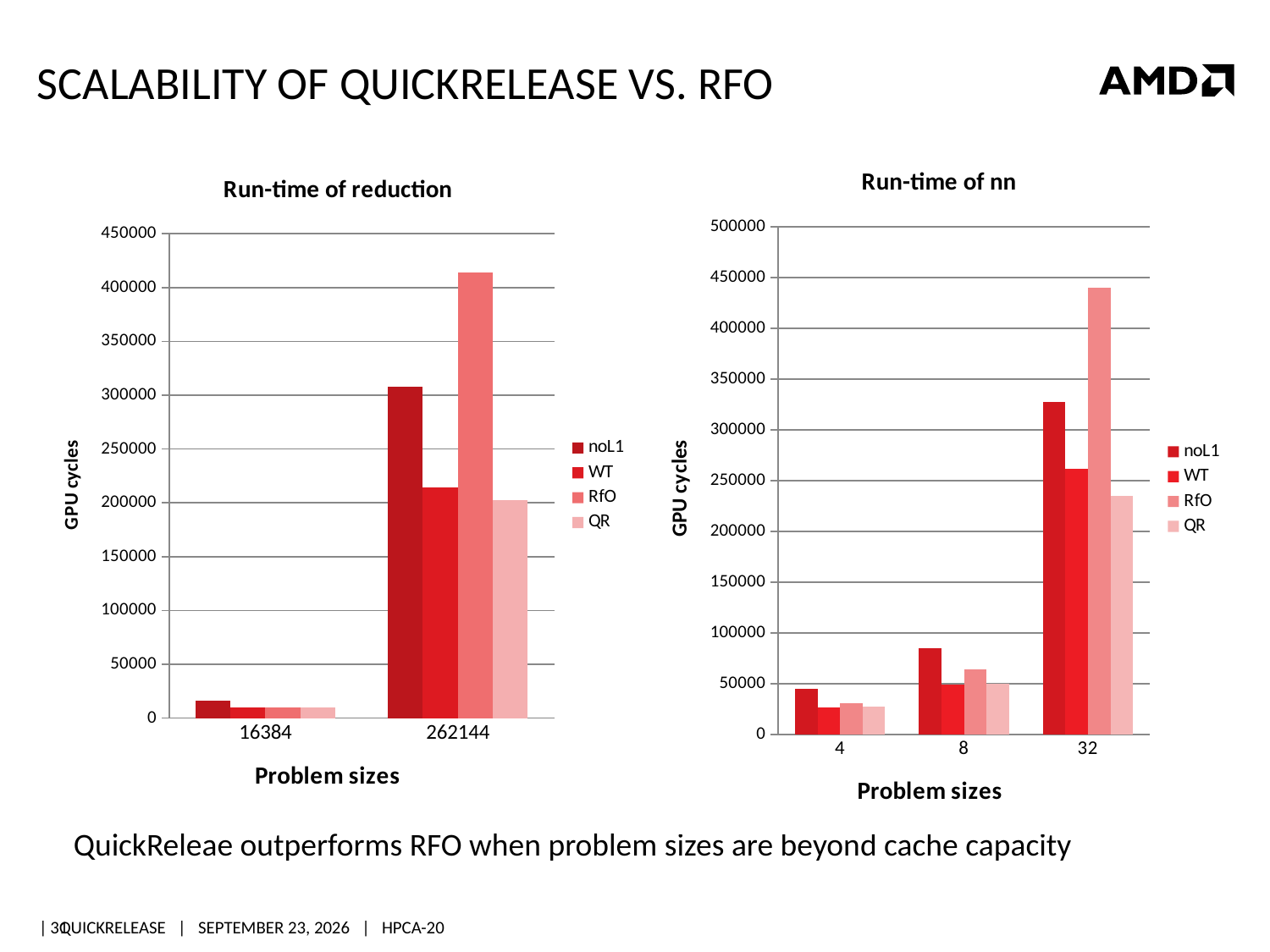
How many series does the legend of the 'Run-time of nn' chart list? 4 In the 'Run-time of reduction' chart, is the RfO value at problem size 262144 greater or less than 400000? greater How many problem sizes are shown on the x axis of the 'Run-time of reduction' chart? 2 In the 'Run-time of reduction' chart, which is larger at problem size 262144: WT or QR? WT In the 'Run-time of nn' chart, which series has the lowest value at problem size 32? QR In the 'Run-time of reduction' chart, is the noL1 value at problem size 262144 greater or less than 300000? greater In the 'Run-time of nn' chart, which is larger at problem size 8: noL1 or RfO? noL1 In the 'Run-time of nn' chart, is the RfO value at problem size 32 greater or less than 400000? greater In the 'Run-time of nn' chart, which series has the highest value at problem size 32? RfO In the 'Run-time of reduction' chart, which series has the highest value at problem size 262144? RfO What kind of chart is the 'Run-time of nn' chart? bar chart In the 'Run-time of nn' chart, do the noL1 values rise or fall as problem size increases from 4 to 32? rise